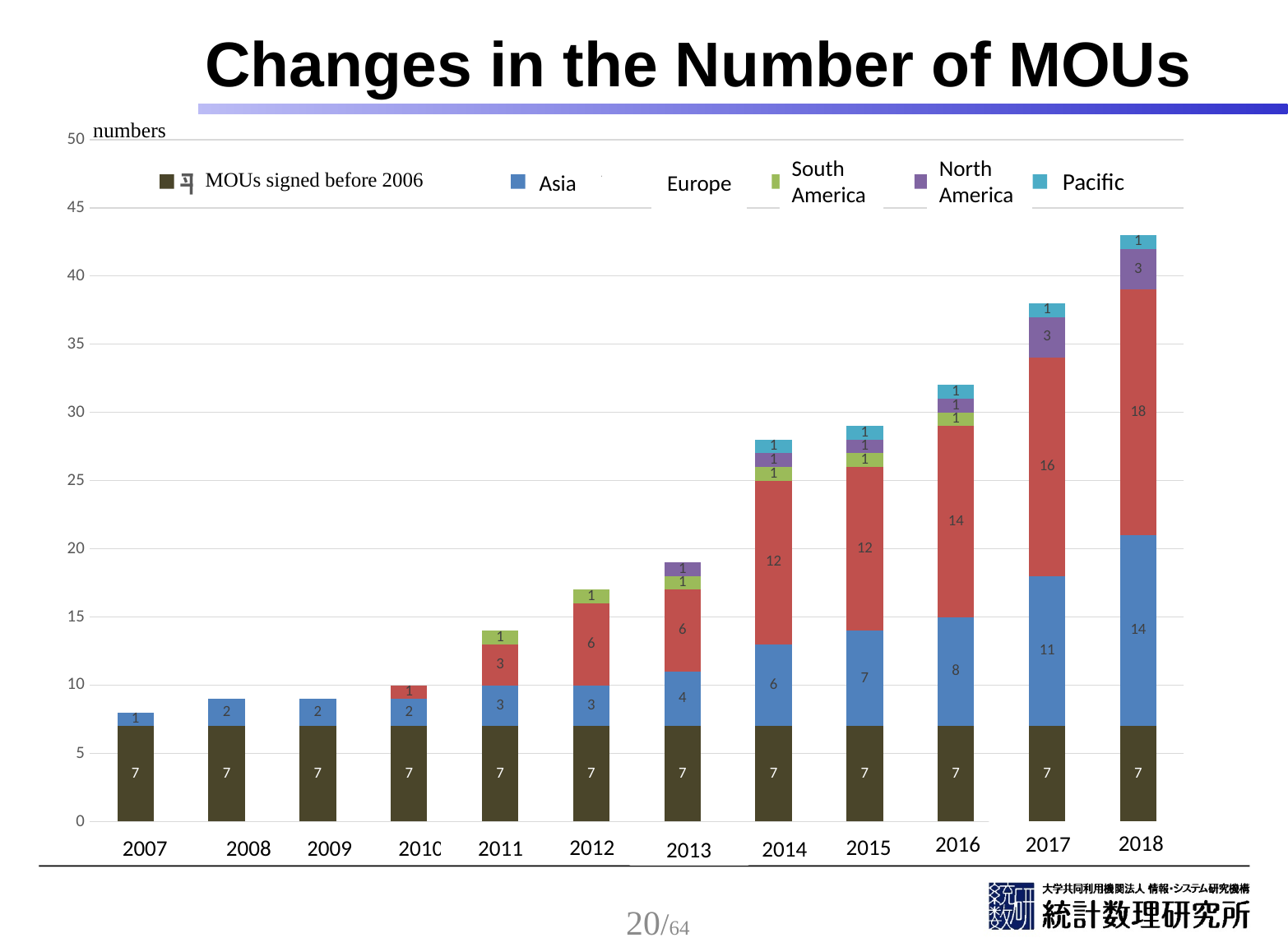
What is the North America value for 2017? 3 What is the Europe value for 2016? 14 What is the total number of MOUs for 2018? 43 Which year has the lowest total number of MOUs? 2007 Is the Asia value for 2015 larger or smaller than the Asia value for 2016? smaller What is the Asia value for 2018? 14 How many years are shown on the x axis? 12 What is the difference between the Europe values for 2018 and 2017? 2 How many series does the legend list? 6 What is the value for MOUs signed before 2006 in 2012? 7 Which year has the highest total number of MOUs? 2018 What kind of chart is shown on the slide? stacked bar chart